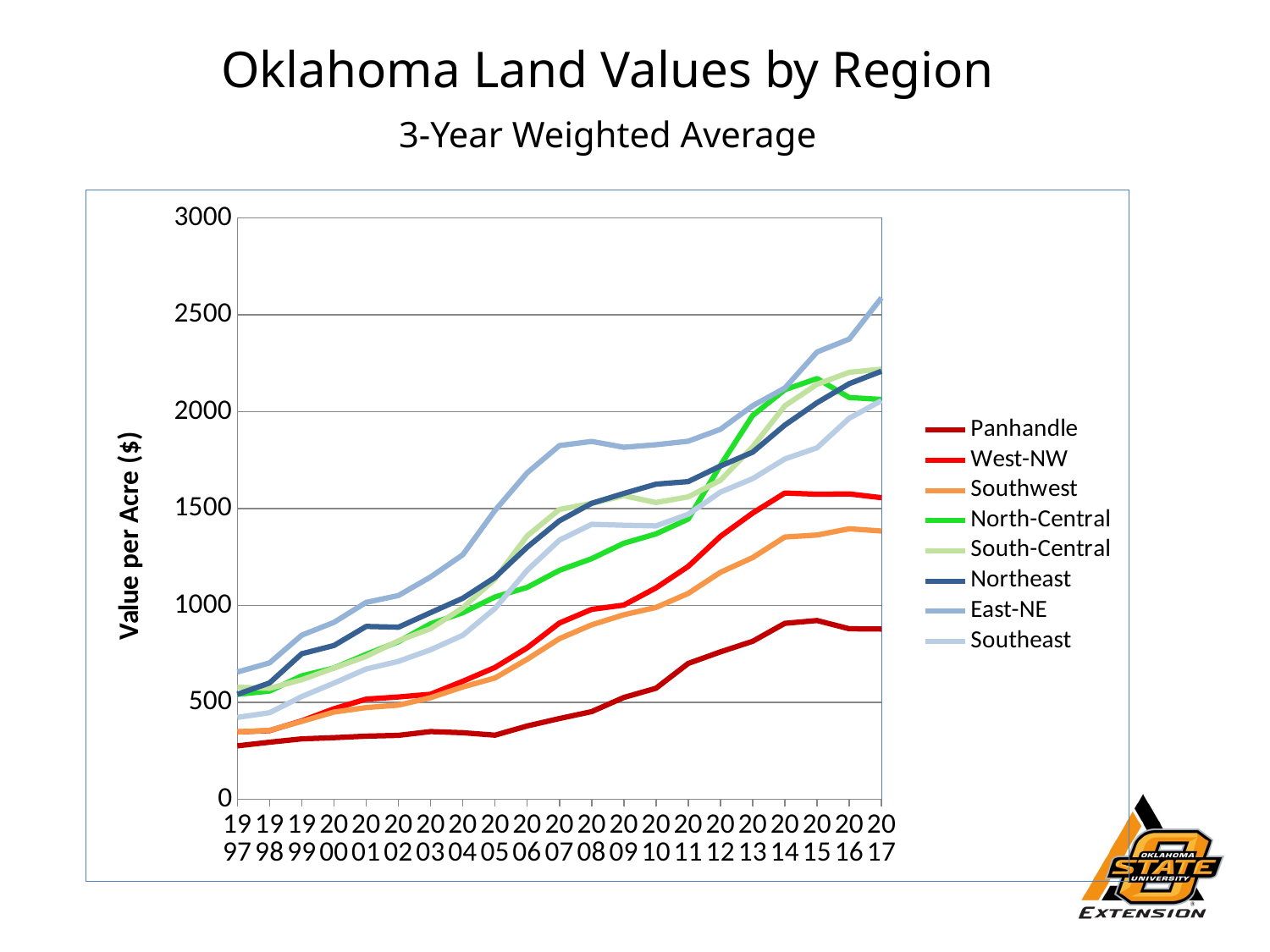
What kind of chart is shown on the slide? line chart Is the value for Southwest in 2017 greater or less than 1500? less Is the value for East-NE in 2017 greater or less than 2500? greater How many years are plotted along the x axis? 21 Is the value for Panhandle in 1997 greater or less than 500? less Which region has the lowest land value in 2017? Panhandle How many series does the legend list? 8 What is the title of the y axis? Value per Acre ($) In 2017, which is larger, the value for Northeast or the value for Southwest? Northeast Which region has the highest land value in 2017? East-NE Does the Panhandle line generally rise or fall from 1997 to 2017? rise